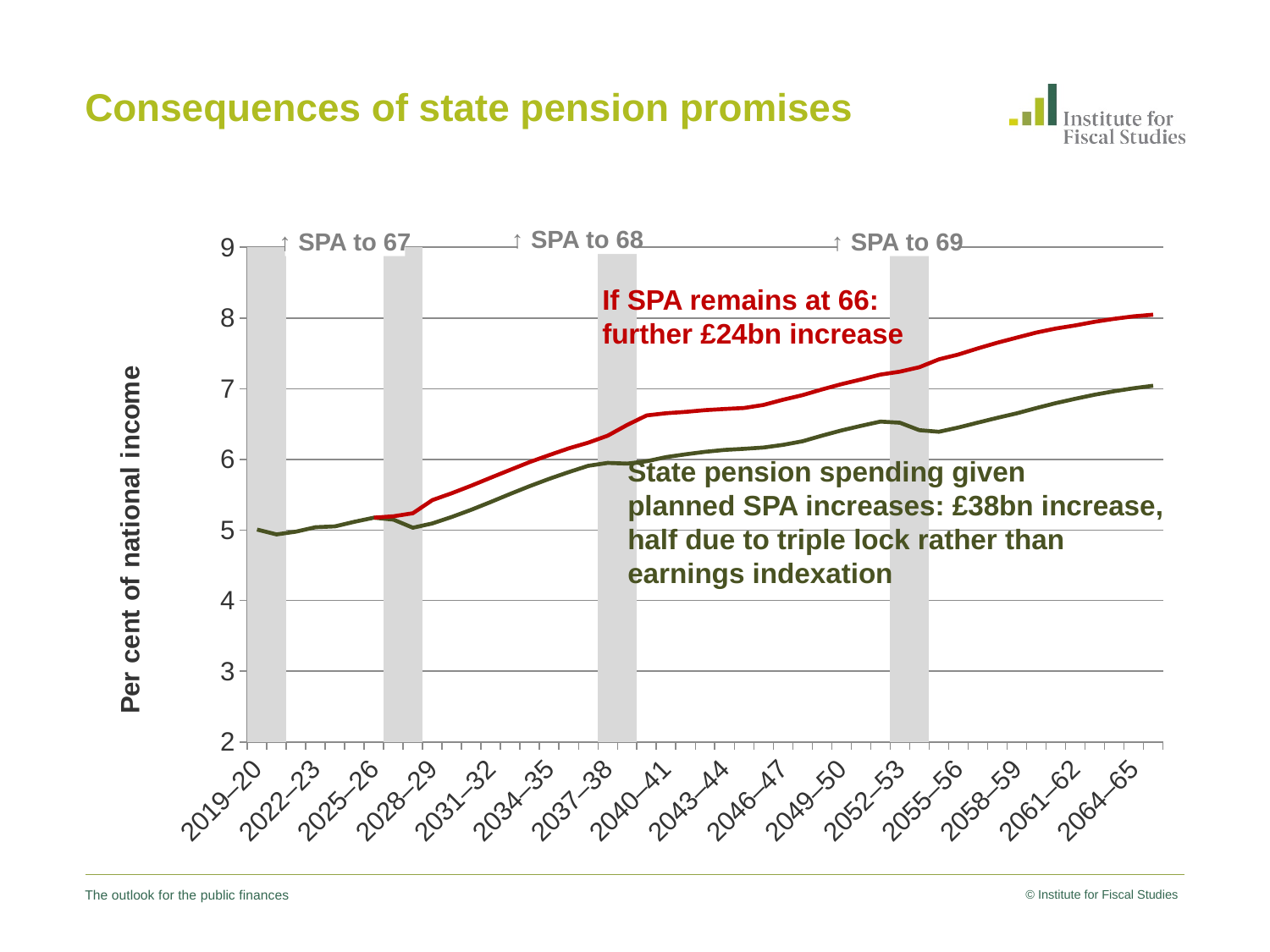
Does the dark green line (planned SPA increases) rise or fall overall from 2019–20 to 2064–65? rise How many year labels are shown along the x axis? 16 Is the value of the red line (SPA remains at 66) at 2040–41 greater or less than 6? greater Is the value of the dark green line (planned SPA increases) at 2064–65 greater or less than 6? greater Does the red line (If SPA remains at 66) rise or fall overall from 2019–20 to 2064–65? rise At 2064–65, which line is higher: the red line (SPA remains at 66) or the dark green line (planned SPA increases)? red line (SPA remains at 66) How many lines are plotted on the chart? 2 Is the value of the red line (SPA remains at 66) at 2052–53 greater or less than 7? greater What is the label on the vertical axis of the chart? Per cent of national income What is the title of the slide's chart? Consequences of state pension promises What kind of chart is shown on the slide? line chart